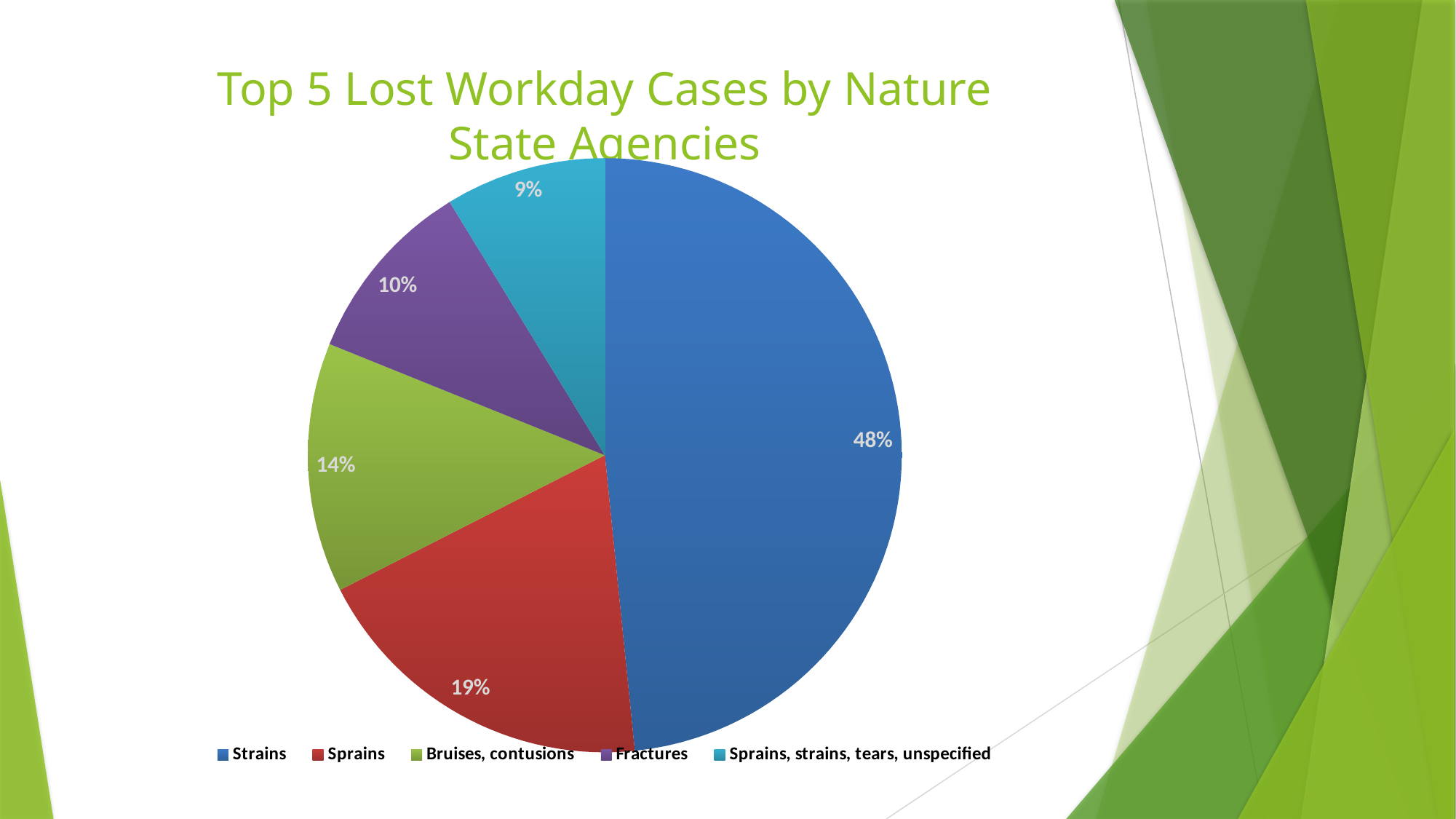
What share of lost workday cases is attributed to Sprains? 19% What share of lost workday cases is attributed to Sprains, strains, tears, unspecified? 9% Which category has the largest slice of the pie? Strains What kind of chart is shown on the slide? Pie chart What is the title of the chart on the slide? Top 5 Lost Workday Cases by Nature State Agencies What share of lost workday cases is attributed to Bruises, contusions? 14% Which is larger, the share for Bruises, contusions or the share for Fractures? Bruises, contusions How many percentage points larger is the Strains share than the Sprains share? 29 Which category has the smallest slice of the pie? Sprains, strains, tears, unspecified How many categories does the pie chart show? 5